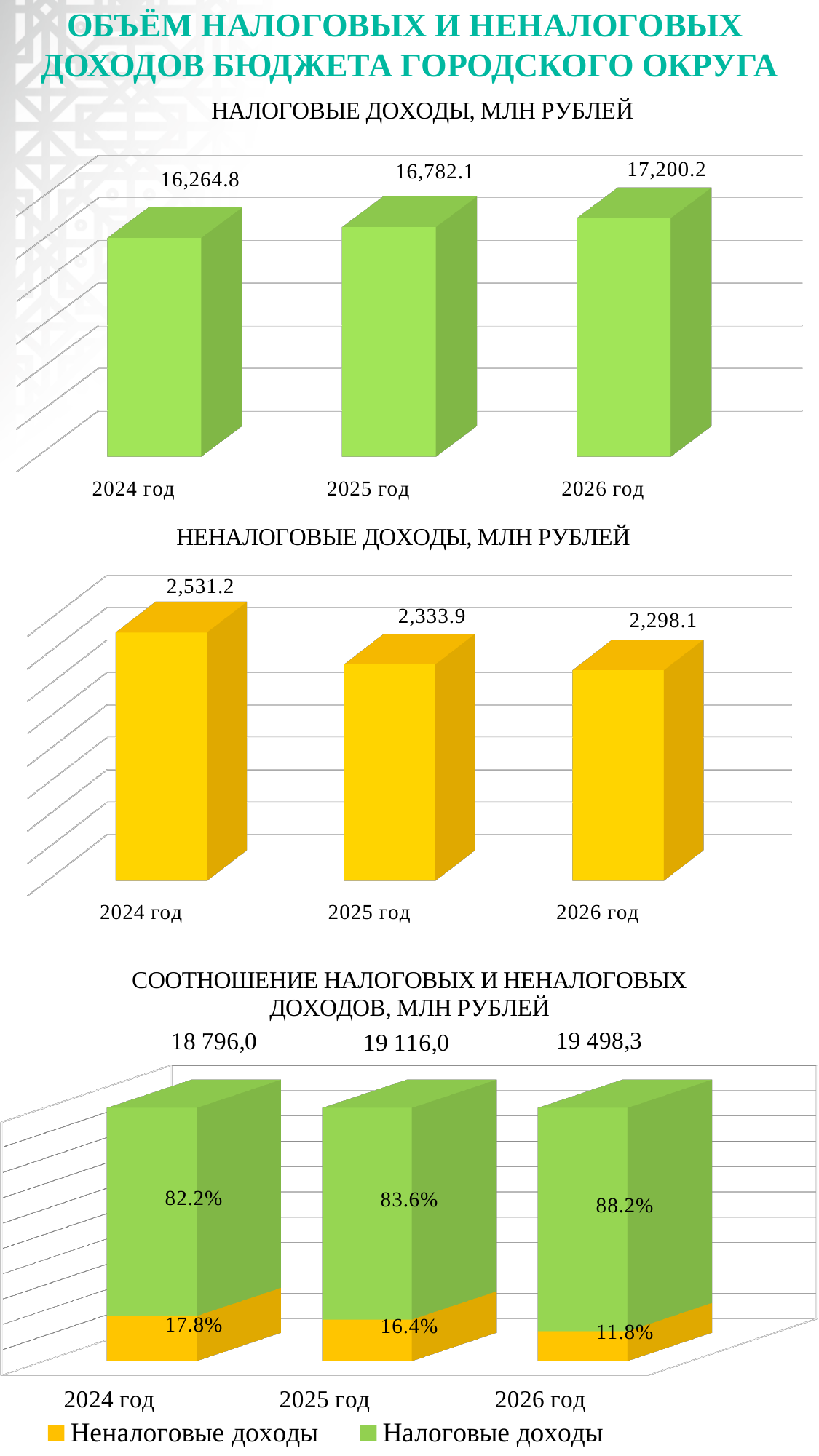
In the bottom chart titled 'СООТНОШЕНИЕ НАЛОГОВЫХ И НЕНАЛОГОВЫХ ДОХОДОВ, МЛН РУБЛЕЙ', what percentage is shown for Неналоговые доходы in 2025 год? 16.4% In the chart titled 'НАЛОГОВЫЕ ДОХОДЫ, МЛН РУБЛЕЙ', what is the value for 2025 год? 16,782.1 In the chart titled 'НЕНАЛОГОВЫЕ ДОХОДЫ, МЛН РУБЛЕЙ', how many years are shown? 3 What type of chart is the chart titled 'НАЛОГОВЫЕ ДОХОДЫ, МЛН РУБЛЕЙ'? bar chart In the chart titled 'НЕНАЛОГОВЫЕ ДОХОДЫ, МЛН РУБЛЕЙ', which year has the lowest value? 2026 год In the chart titled 'НАЛОГОВЫЕ ДОХОДЫ, МЛН РУБЛЕЙ', which year has the highest value? 2026 год In the chart titled 'НАЛОГОВЫЕ ДОХОДЫ, МЛН РУБЛЕЙ', do the values rise or fall from 2024 год to 2026 год? rise In the chart titled 'НЕНАЛОГОВЫЕ ДОХОДЫ, МЛН РУБЛЕЙ', what is the difference between the values for 2024 год and 2026 год? 233.1 In the chart titled 'НЕНАЛОГОВЫЕ ДОХОДЫ, МЛН РУБЛЕЙ', what is the value for 2024 год? 2,531.2 In the bottom chart titled 'СООТНОШЕНИЕ НАЛОГОВЫХ И НЕНАЛОГОВЫХ ДОХОДОВ, МЛН РУБЛЕЙ', what is the total shown above the bar for 2026 год? 19 498,3 In the bottom chart titled 'СООТНОШЕНИЕ НАЛОГОВЫХ И НЕНАЛОГОВЫХ ДОХОДОВ, МЛН РУБЛЕЙ', how many series does the legend list? 2 In the chart titled 'НАЛОГОВЫЕ ДОХОДЫ, МЛН РУБЛЕЙ', what is the difference between the values for 2026 год and 2024 год? 935.4